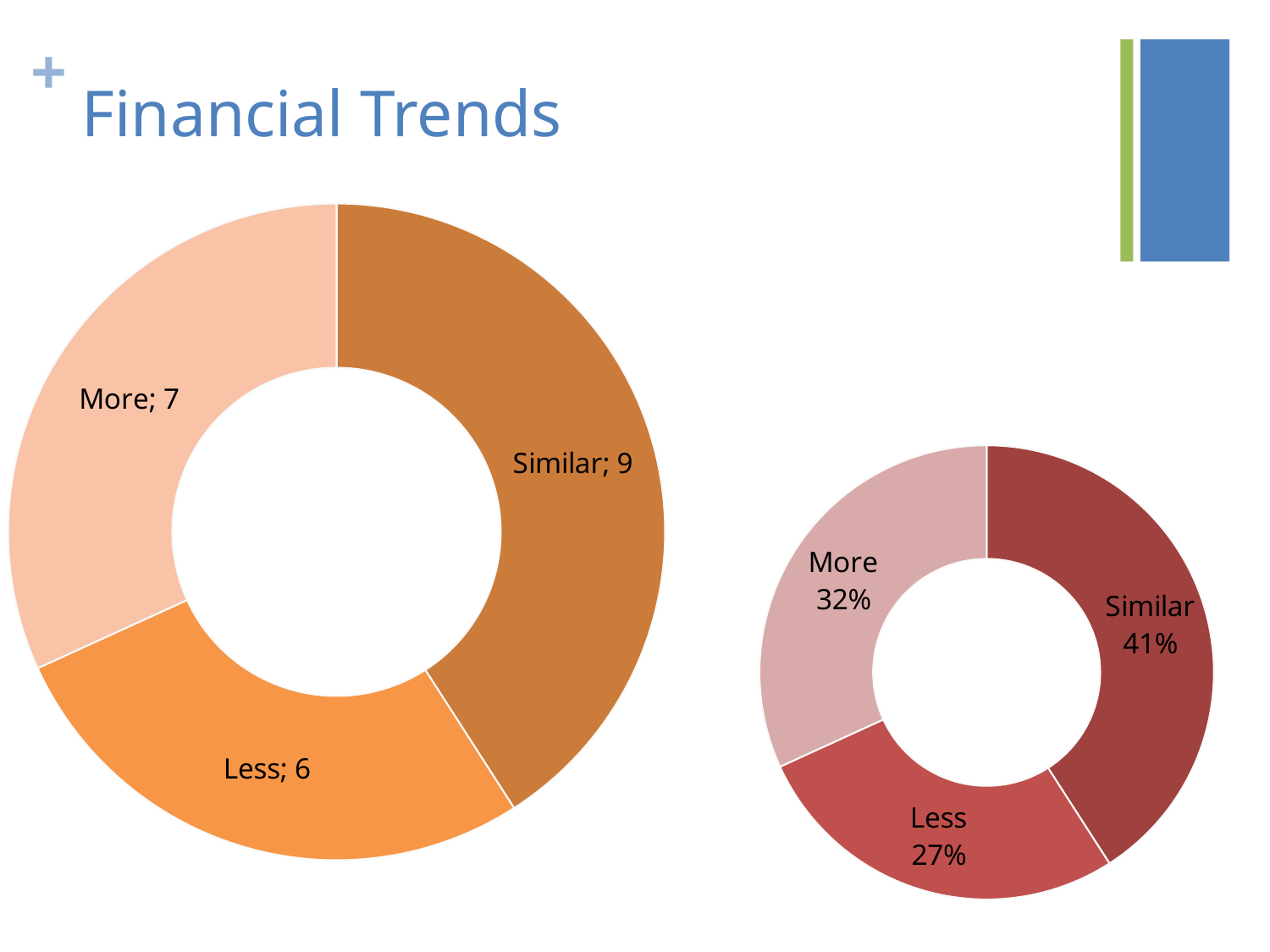
In the left doughnut chart, what is the value for Similar? 9 In the left doughnut chart, what is the total of all three categories? 22 In the left doughnut chart, which category has the highest value? Similar In the right doughnut chart, is the share for More larger or smaller than the share for Similar? smaller In the right doughnut chart, what percentage is shown for Similar? 41% In the right doughnut chart, what percentage is shown for Less? 27% In the left doughnut chart, which category has the lowest value? Less In the right doughnut chart, which category has the smallest share? Less In the left doughnut chart, what is the value for Less? 6 In the left doughnut chart, what is the difference between the values for Similar and Less? 3 How many categories does the right doughnut chart show? 3 In the left doughnut chart, what is the value for More? 7